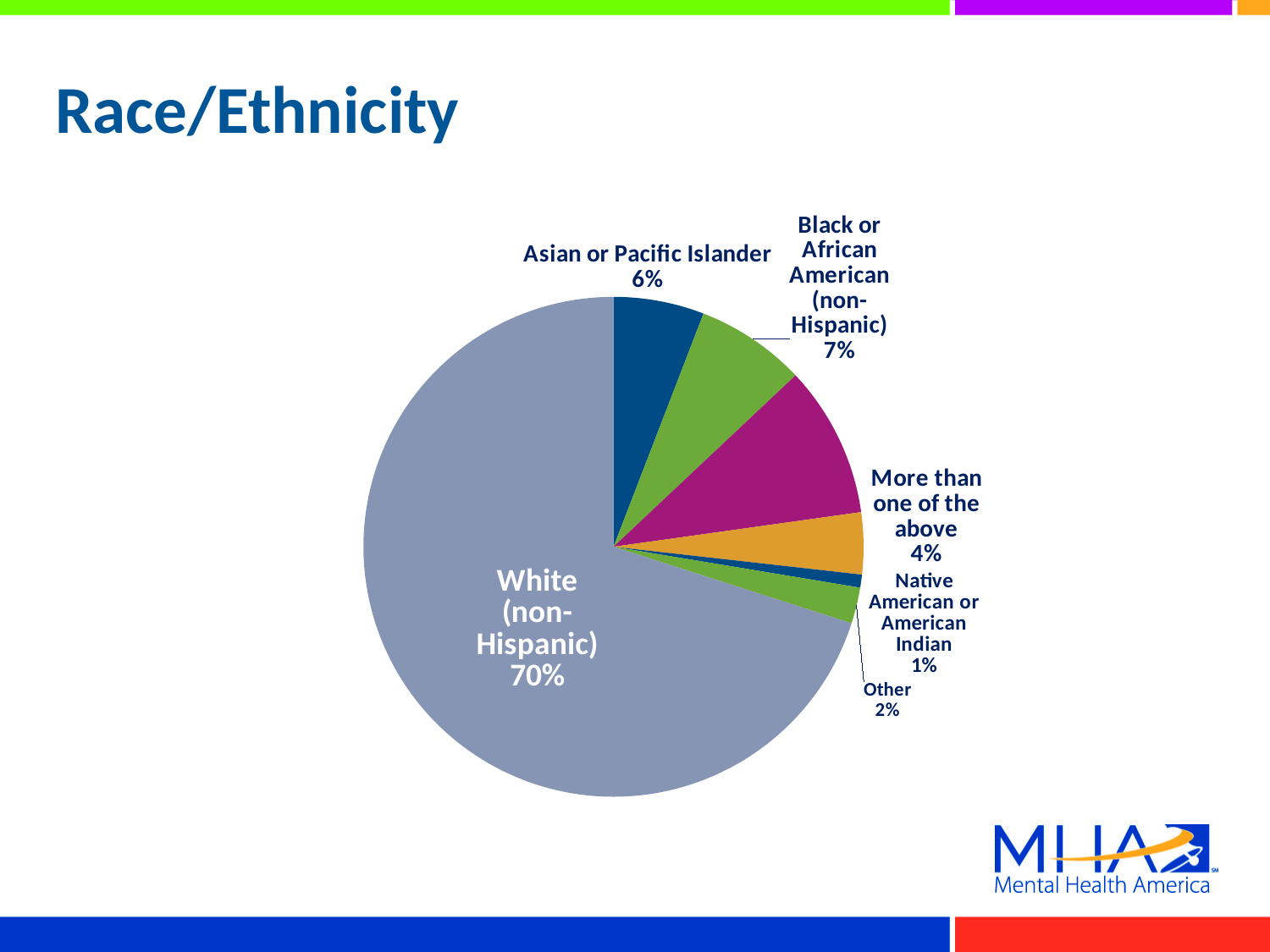
What is the value for Black or African American (non-Hispanic)? 7% What is the title of the slide containing the pie chart? Race/Ethnicity What type of chart is shown on the slide? Pie chart Which is larger, the share for Other or the share for Native American or American Indian? Other What is the value for Asian or Pacific Islander? 6% What is the difference between the Black or African American (non-Hispanic) share and the Asian or Pacific Islander share? 1% Which labeled category has the smallest share of the pie? Native American or American Indian Which category has the largest share of the pie? White (non-Hispanic) What is the value for Other? 2% What is the value for More than one of the above? 4% What percentage of the pie is White (non-Hispanic)? 70% What is the value for Native American or American Indian? 1%